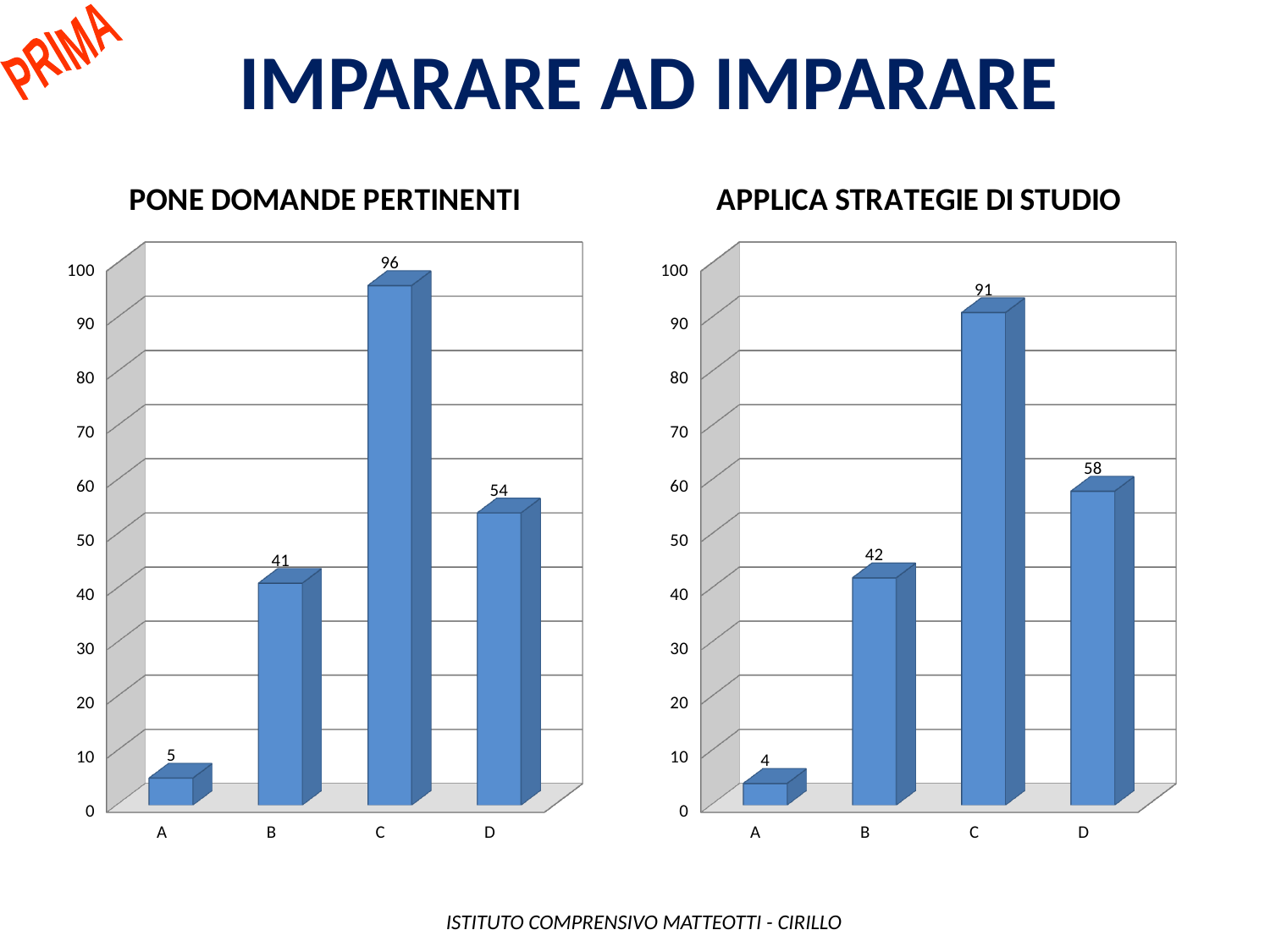
What is the title of the chart on the right side of the slide? APPLICA STRATEGIE DI STUDIO In the 'PONE DOMANDE PERTINENTI' chart, what is the difference between the values for C and D? 42 In the 'PONE DOMANDE PERTINENTI' chart, which is larger, the value for B or the value for D? D In the 'PONE DOMANDE PERTINENTI' chart, which category has the lowest value? A In the 'PONE DOMANDE PERTINENTI' chart, what is the value for category A? 5 In the 'PONE DOMANDE PERTINENTI' chart, what is the value for category C? 96 In the 'APPLICA STRATEGIE DI STUDIO' chart, what is the value for category B? 42 In the 'APPLICA STRATEGIE DI STUDIO' chart, what is the difference between the values for D and A? 54 In the 'APPLICA STRATEGIE DI STUDIO' chart, which category has the highest value? C How many categories are shown in the 'PONE DOMANDE PERTINENTI' chart? 4 In the 'APPLICA STRATEGIE DI STUDIO' chart, is the value for C greater or less than 80? greater What kind of chart is the 'APPLICA STRATEGIE DI STUDIO' chart? bar chart